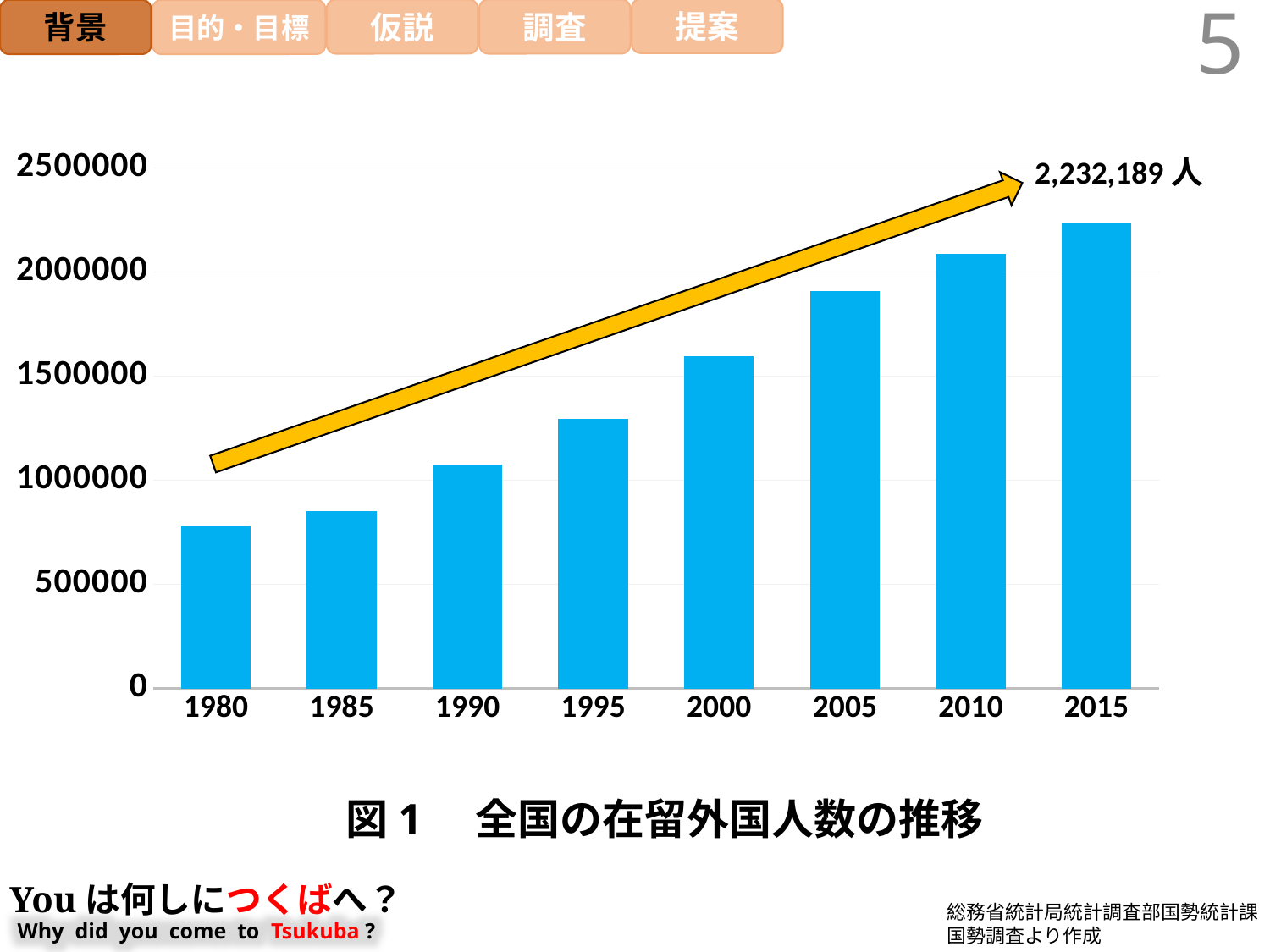
Which year has the highest bar? 2015 What is the title of the chart (the figure caption below it)? 図１ 全国の在留外国人数の推移 Is the value for 1980 greater or less than 1000000? less What kind of chart is shown on the slide? bar chart Do the values rise or fall from 1980 to 2015? rise What value is labelled for 2015? 2,232,189 人 Which year has the lowest bar? 1980 How many years (bars) are plotted on the x axis? 8 Which is larger, the value for 1995 or the value for 2000? 2000 Is the value for 2010 greater or less than 2000000? greater Is the value for 2000 greater or less than 1500000? greater